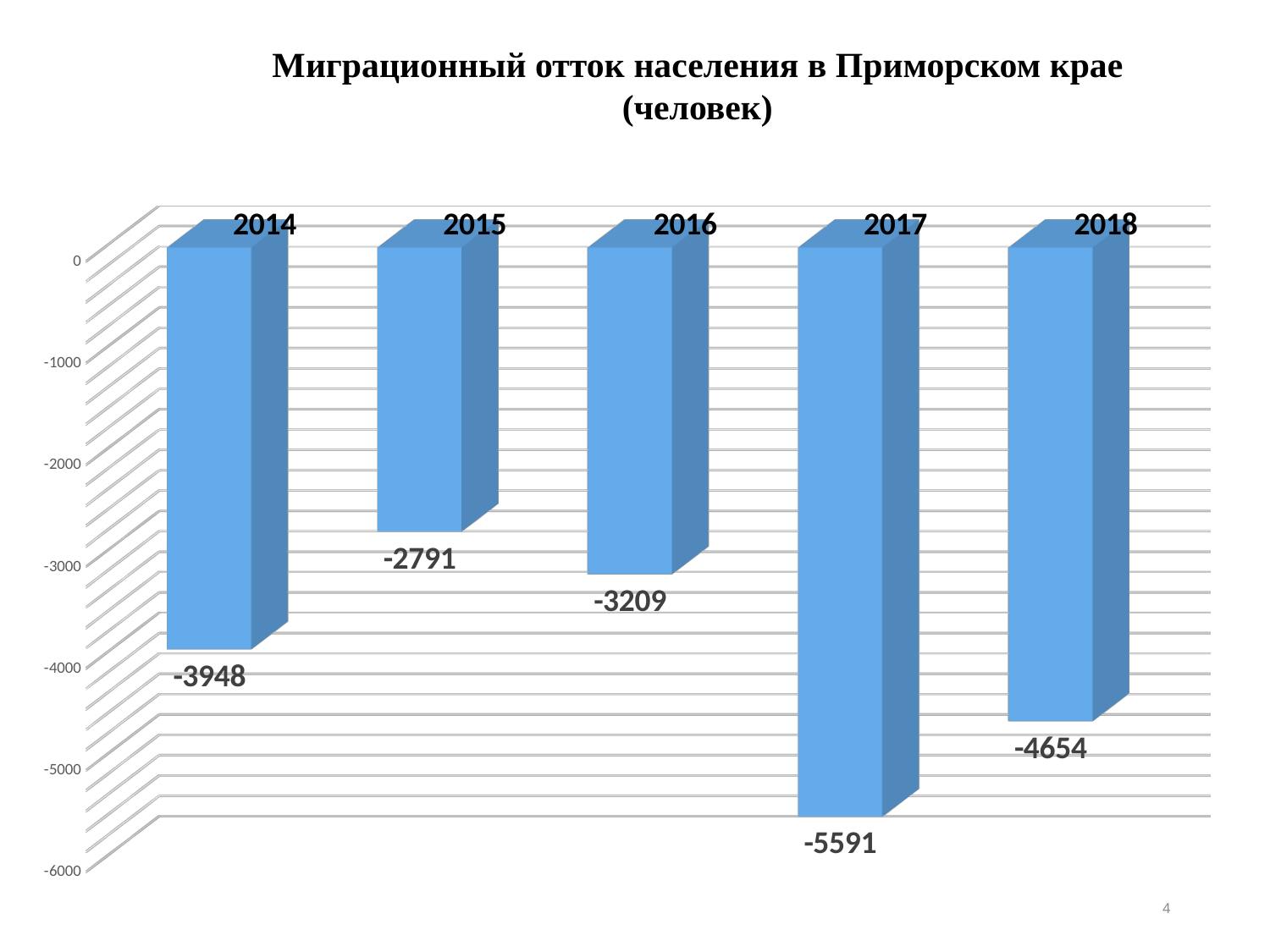
What is the value for 2015? -2791 Which year has the highest (least negative) value? 2015 What kind of chart is this? bar chart How many years are shown on the chart? 5 What is the difference between the values for 2014 and 2015? 1157 Which year has the lowest (most negative) value? 2017 What is the value for 2018? -4654 What is the difference between the values for 2017 and 2018? 937 Which value is larger, 2015 or 2016? 2015 What is the value for 2016? -3209 What is the value for 2017? -5591 What is the value for 2014? -3948